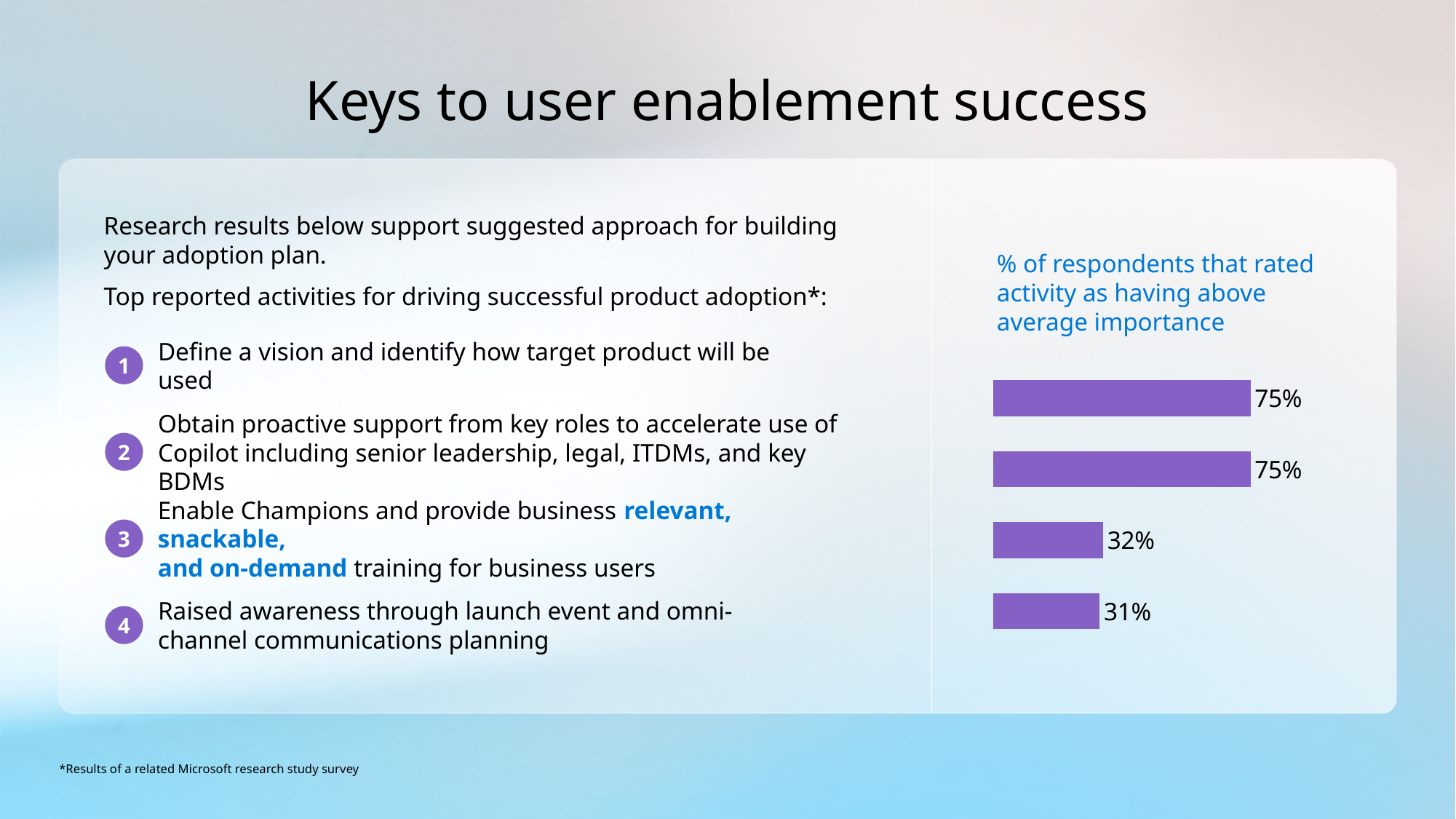
What is the difference between the top bar's value and the bottom bar's value in the chart? 44% What is the value shown for the bottom bar in the chart? 31% What is the title of the chart on the right side of the slide? % of respondents that rated activity as having above average importance What is the value shown for the second bar from the top in the chart? 75% What is the value shown for the top bar in the chart? 75% What is the difference between the third bar's value and the bottom bar's value in the chart? 1% What type of chart is shown on the right side of the slide? bar chart Which bar in the chart has the lowest value? the bottom bar (31%) Do the bar values rise or fall going from the top bar to the bottom bar of the chart? fall Which is larger in the chart: the value of the second bar from the top or the value of the third bar from the top? the second bar from the top (75%) What is the value shown for the third bar from the top in the chart? 32% How many bars does the chart on the right show? 4